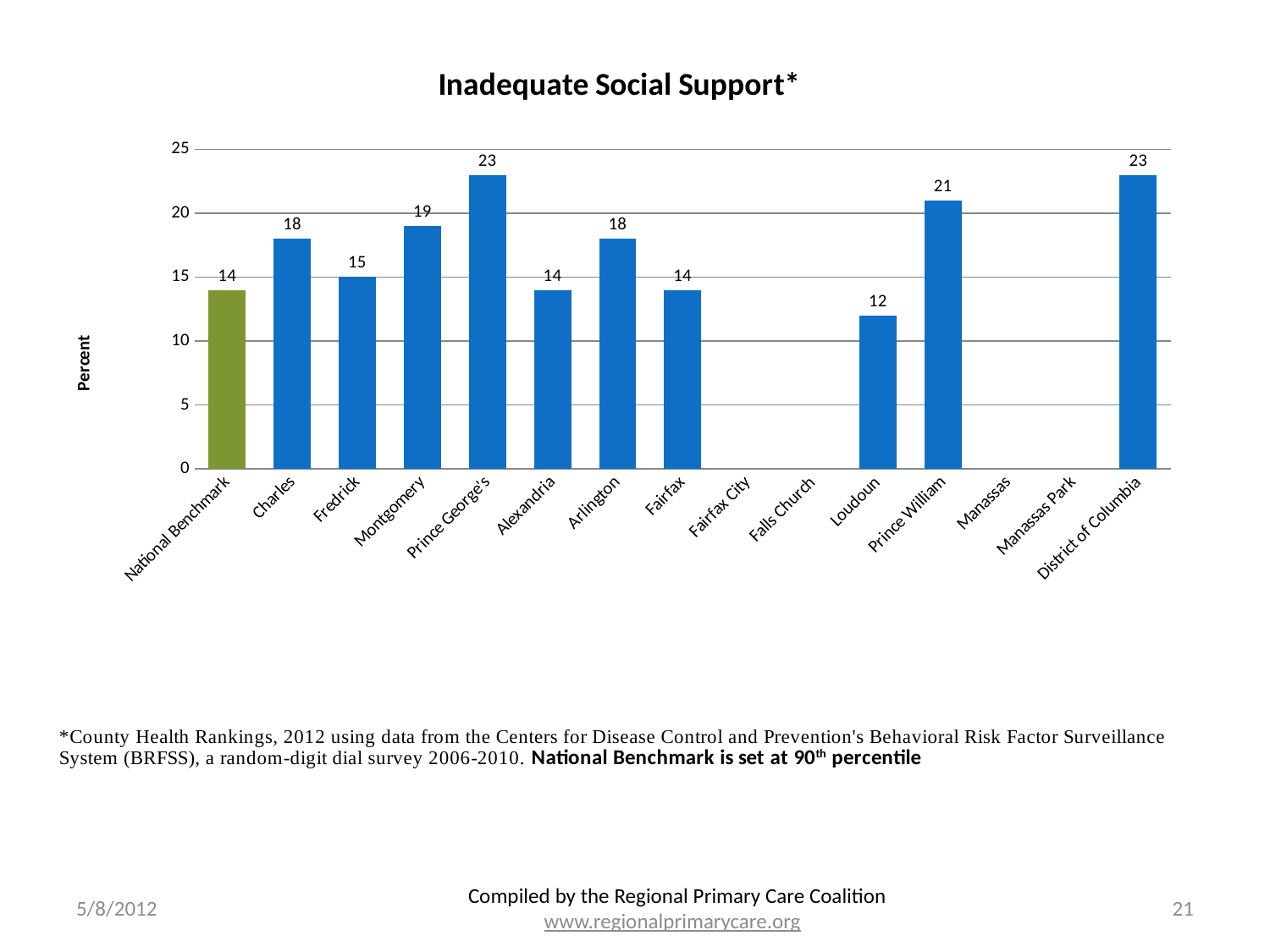
How many categories are listed along the x axis? 15 Which two categories share the highest value of 23? Prince George's and District of Columbia What is the title of the chart? Inadequate Social Support* What is the value for Montgomery? 19 What is the value for Prince William? 21 What is the value for Loudoun? 12 Which category has the lowest plotted value? Loudoun What is the difference between the values for Prince George's and Loudoun? 11 Which is larger, the value for Arlington or the value for Fairfax? Arlington What is the difference between the values for Charles and Fredrick? 3 What is the value for the National Benchmark? 14 What kind of chart is shown on the slide? Bar chart